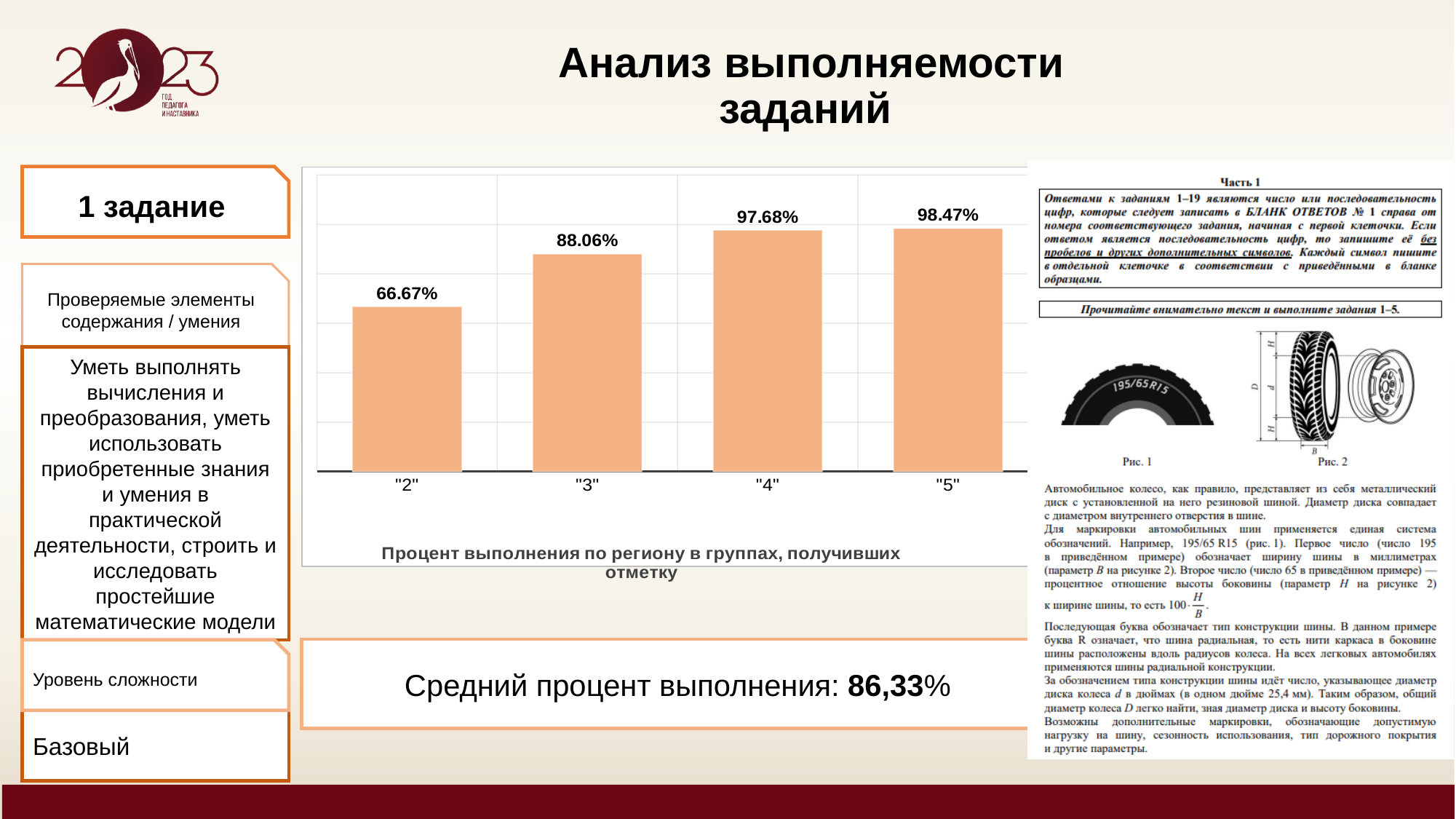
What is the percentage of completion for the group that received mark "2"? 66.67% What is the percentage of completion for the group that received mark "5"? 98.47% What is the percentage of completion for the group that received mark "4"? 97.68% What is the percentage of completion for the group that received mark "3"? 88.06% What type of chart is used to show the completion percentages? Bar chart What is the difference in completion percentage between the "5" group and the "4" group? 0.79% How many mark groups are shown in the chart? 4 Which mark group has the lowest percentage of completion? "2" What is the difference in completion percentage between the "3" group and the "2" group? 21.39% Which group has a higher completion percentage, "3" or "4"? "4" Do the completion percentages rise or fall as the mark increases from "2" to "5"? Rise Which mark group has the highest percentage of completion? "5"